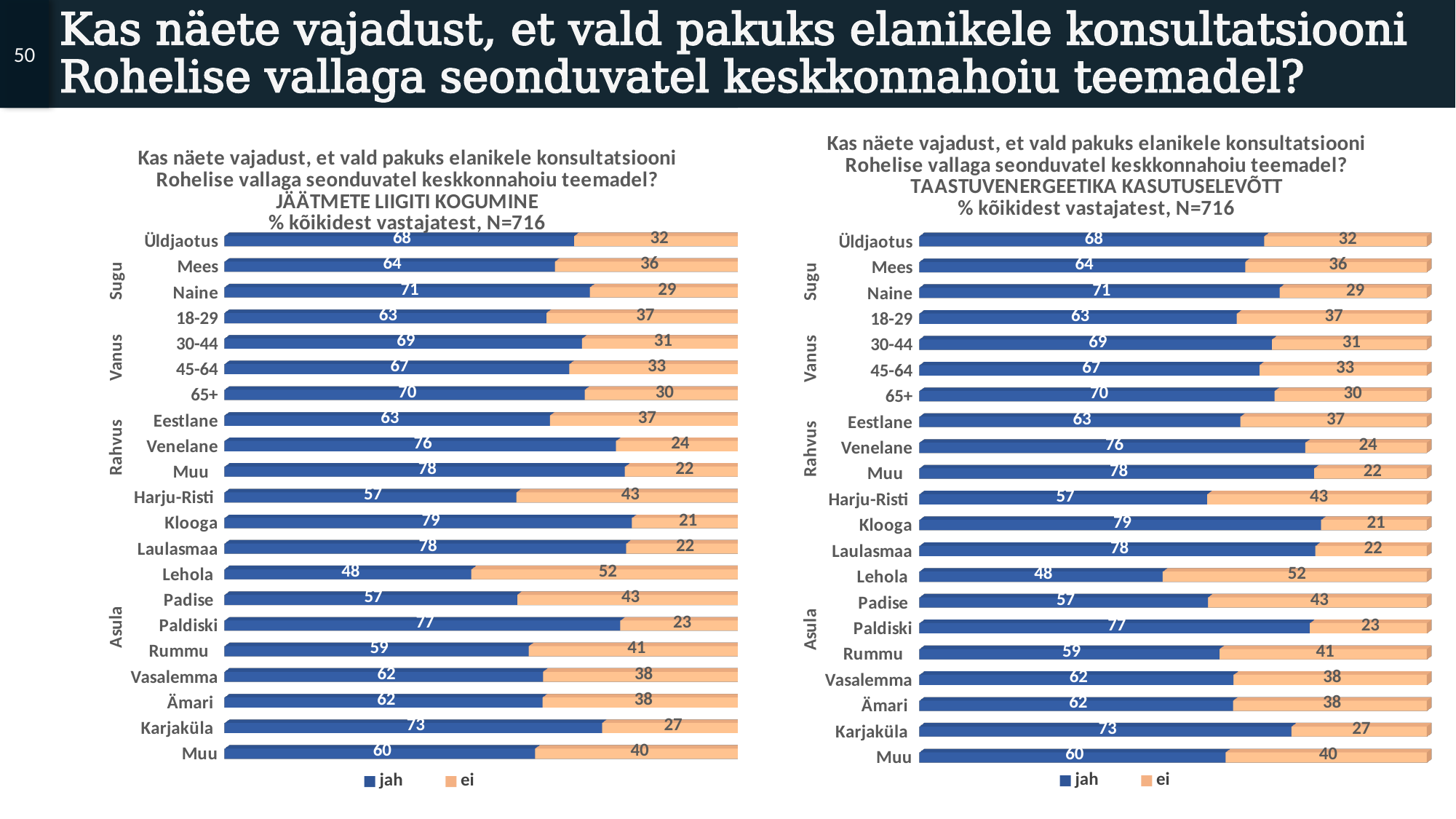
How many series does the legend of the left chart (JÄÄTMETE LIIGITI KOGUMINE) list? 2 In the right chart (TAASTUVENERGEETIKA KASUTUSELEVÕTT), which has a larger 'jah' value, Mees or Naine? Naine In the right chart (TAASTUVENERGEETIKA KASUTUSELEVÕTT), which category has the lowest 'jah' value? Lehola What kind of chart is the left chart (JÄÄTMETE LIIGITI KOGUMINE)? Stacked bar chart In the left chart (JÄÄTMETE LIIGITI KOGUMINE), what is the 'jah' value for Üldjaotus? 68 What are the two legend entries of the right chart (TAASTUVENERGEETIKA KASUTUSELEVÕTT)? jah and ei In the right chart (TAASTUVENERGEETIKA KASUTUSELEVÕTT), what is the 'jah' value for Paldiski? 77 In the left chart (JÄÄTMETE LIIGITI KOGUMINE), which category has the highest 'jah' value? Klooga How many categories are shown on the y axis of the right chart (TAASTUVENERGEETIKA KASUTUSELEVÕTT)? 21 In the right chart (TAASTUVENERGEETIKA KASUTUSELEVÕTT), what is the 'ei' value for Lehola? 52 In the left chart (JÄÄTMETE LIIGITI KOGUMINE), what is the difference between the 'jah' values for Venelane and Eestlane? 13 In the left chart (JÄÄTMETE LIIGITI KOGUMINE), what is the total of the stacked bar for Karjaküla? 100